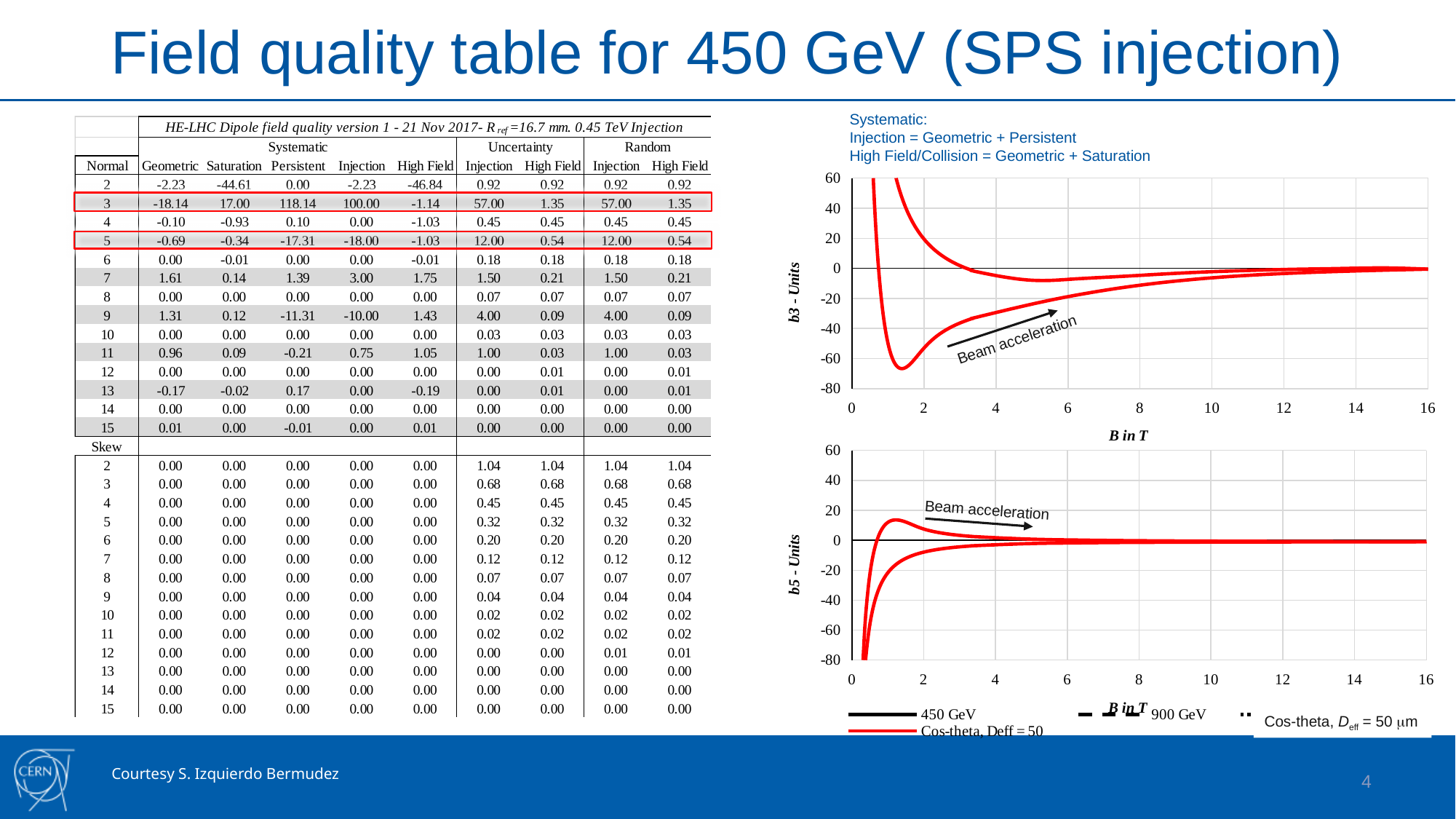
In the upper b3 chart, is the lowest point of the red curve (near B = 1.5 T) greater or less than -60? less In the lower b5 chart, is the value of the red curves at B = 12 T greater or less than -20? greater In the upper b3 chart, is the value of the red curves at B = 14 T greater or less than -20? greater What kind of chart is the upper chart (b3 - Units versus B in T)? line chart What kind of chart is the lower chart (b5 - Units versus B in T)? line chart In the lower b5 chart, does the lower red curve rise or fall as B increases from 0.5 T to 6 T? rise What is the y-axis label of the lower chart? b5 - Units What is the x-axis label of the upper b3 chart? B in T In the upper b3 chart, does the lower red curve rise or fall as B increases from 2 T to 16 T? rise